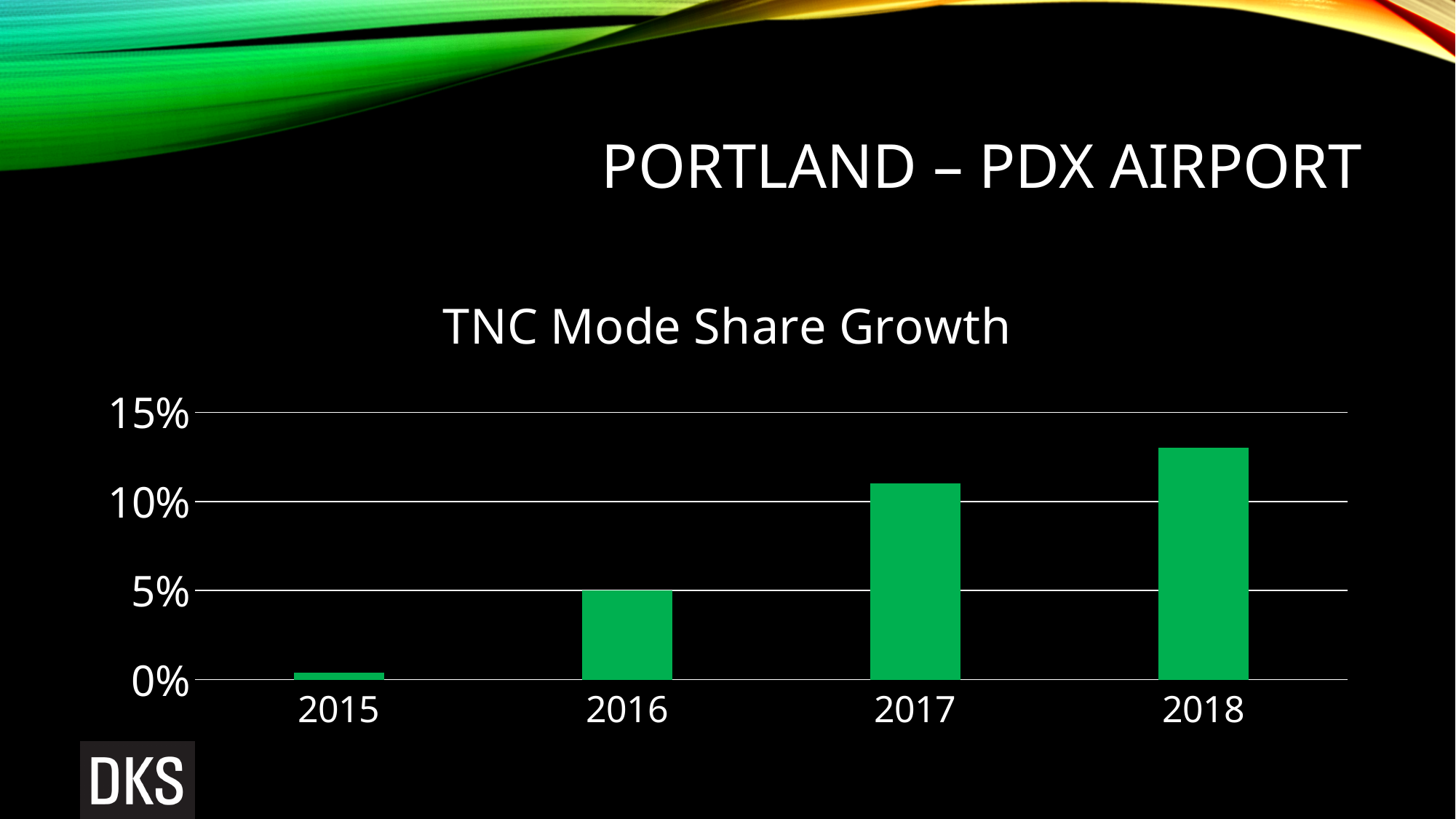
Which year has the lowest TNC mode share? 2015 Is the value for 2015 greater or less than 5%? less Do the values rise or fall from 2015 to 2018? rise Is the value for 2017 greater or less than 10%? greater Which year has the highest TNC mode share? 2018 Which year has the larger value, 2017 or 2018? 2018 What is the TNC mode share for 2016? 5% Which year has the larger value, 2016 or 2017? 2017 What is the title of the chart? TNC Mode Share Growth Is the value for 2018 greater or less than 15%? less How many years are shown on the x axis of the chart? 4 What kind of chart is shown on the slide? bar chart